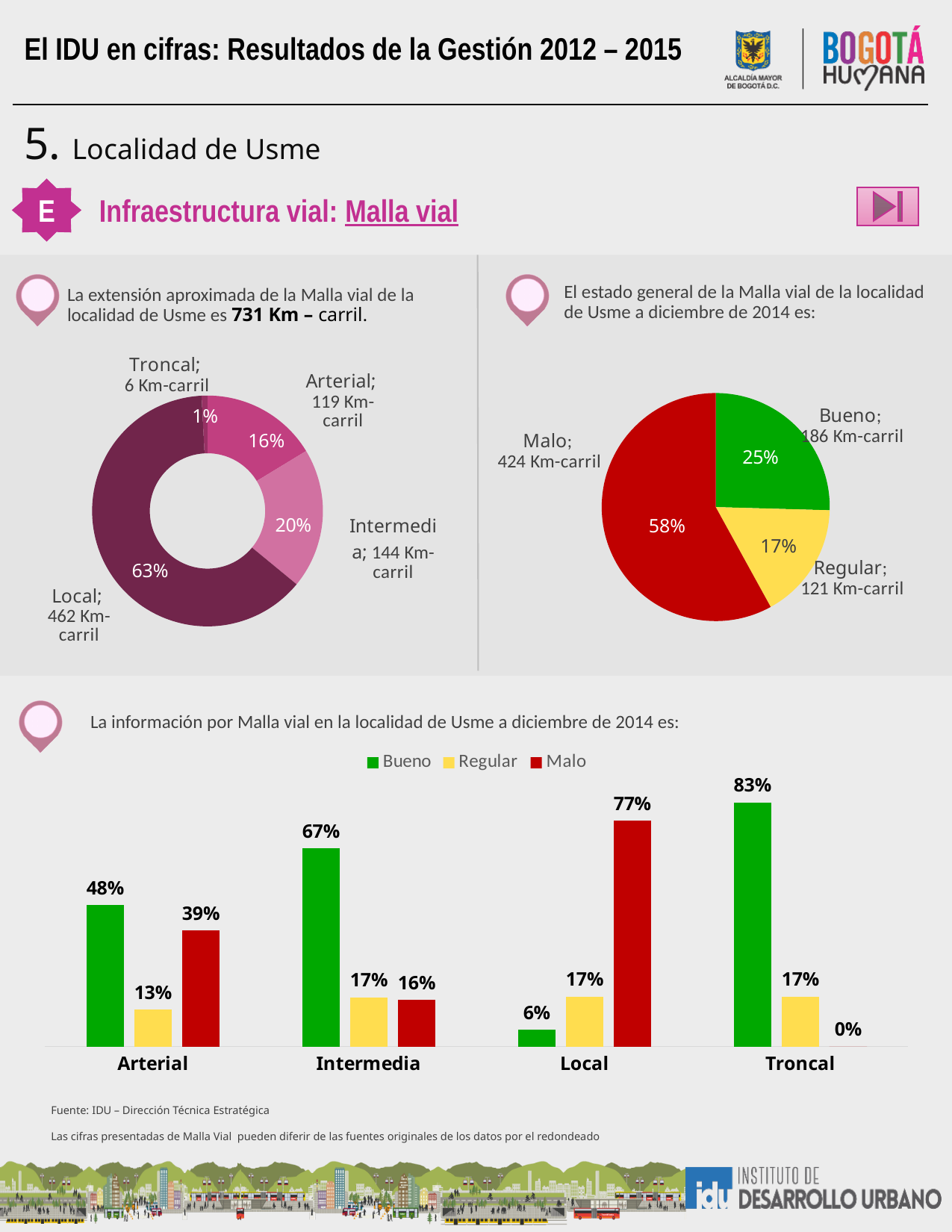
In the bottom bar chart, which category has the lowest Malo value? Troncal How many series does the legend of the bottom bar chart list? 3 In the donut chart on the left (extensión de la Malla vial), how many Km-carril does Intermedia have? 144 Km-carril In the bottom bar chart, what is the Malo value for Local? 77% In the bottom bar chart, which category has the highest Bueno value? Troncal How many categories are shown on the x axis of the bottom bar chart? 4 In the donut chart on the left (extensión de la Malla vial), which category has the largest share? Local In the bottom bar chart, which is larger for Arterial: Bueno or Malo? Bueno In the pie chart on the right (estado general de la Malla vial), what share does Malo have? 58% In the bottom bar chart, what is the difference between the Bueno values for Intermedia and Arterial? 19% In the bottom bar chart, what is the Bueno value for Troncal? 83% In the pie chart on the right (estado general de la Malla vial), how many Km-carril are in Regular state? 121 Km-carril